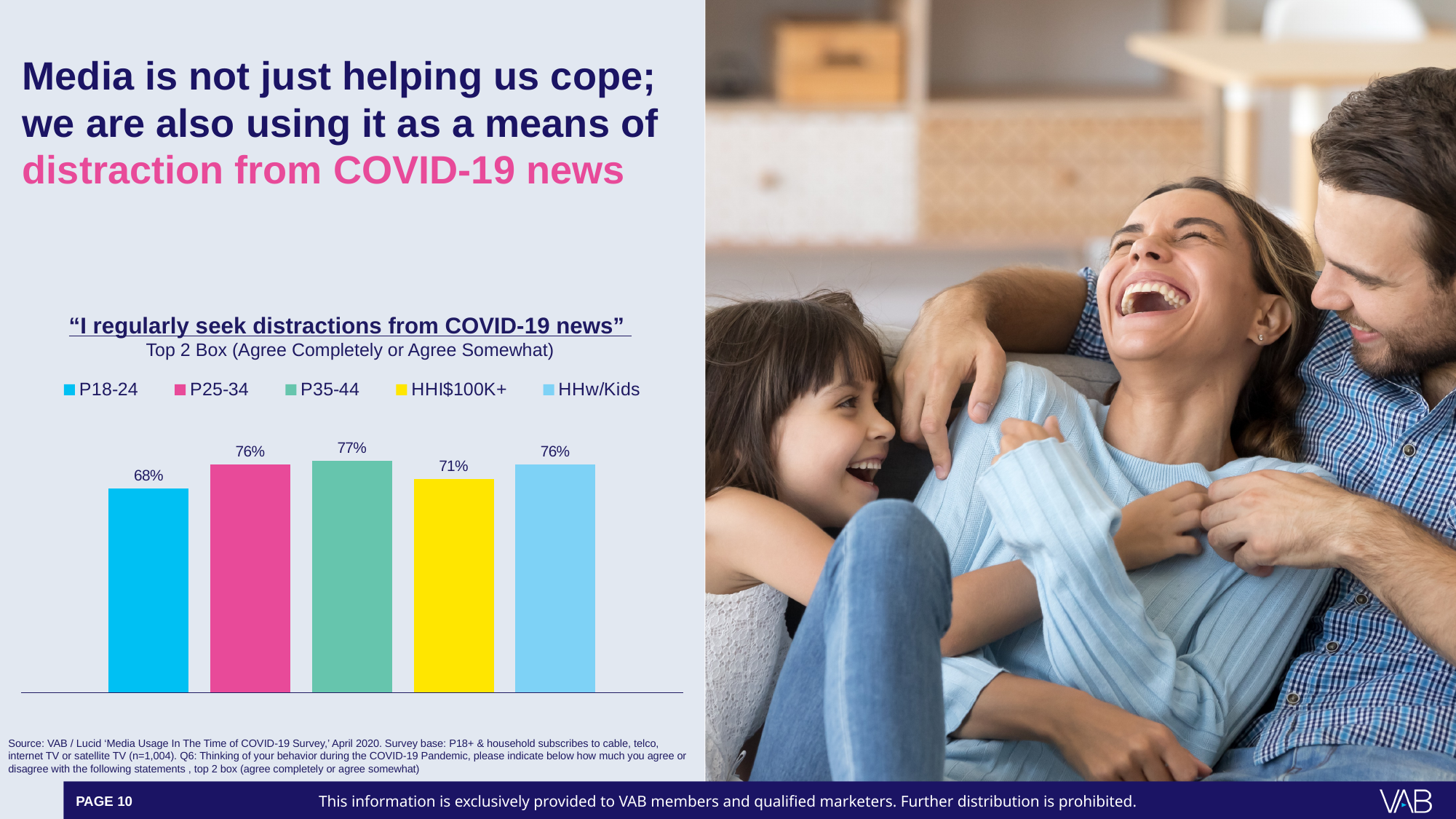
How many entries does the chart legend list? 5 What is the difference between the values for P35-44 and P18-24? 9% What is the value shown for P35-44? 77% Which group has the lowest value in the chart? P18-24 What type of chart is shown on the slide? Bar chart What is the value shown for HHI$100K+? 71% Which is larger, the value for P18-24 or the value for HHI$100K+? HHI$100K+ What percentage of P18-24 agree with "I regularly seek distractions from COVID-19 news"? 68% How many bars are shown in the chart? 5 What is the difference between the values for P25-34 and HHI$100K+? 5% What is the value shown for HHw/Kids? 76% Which group has the highest value in the chart? P35-44